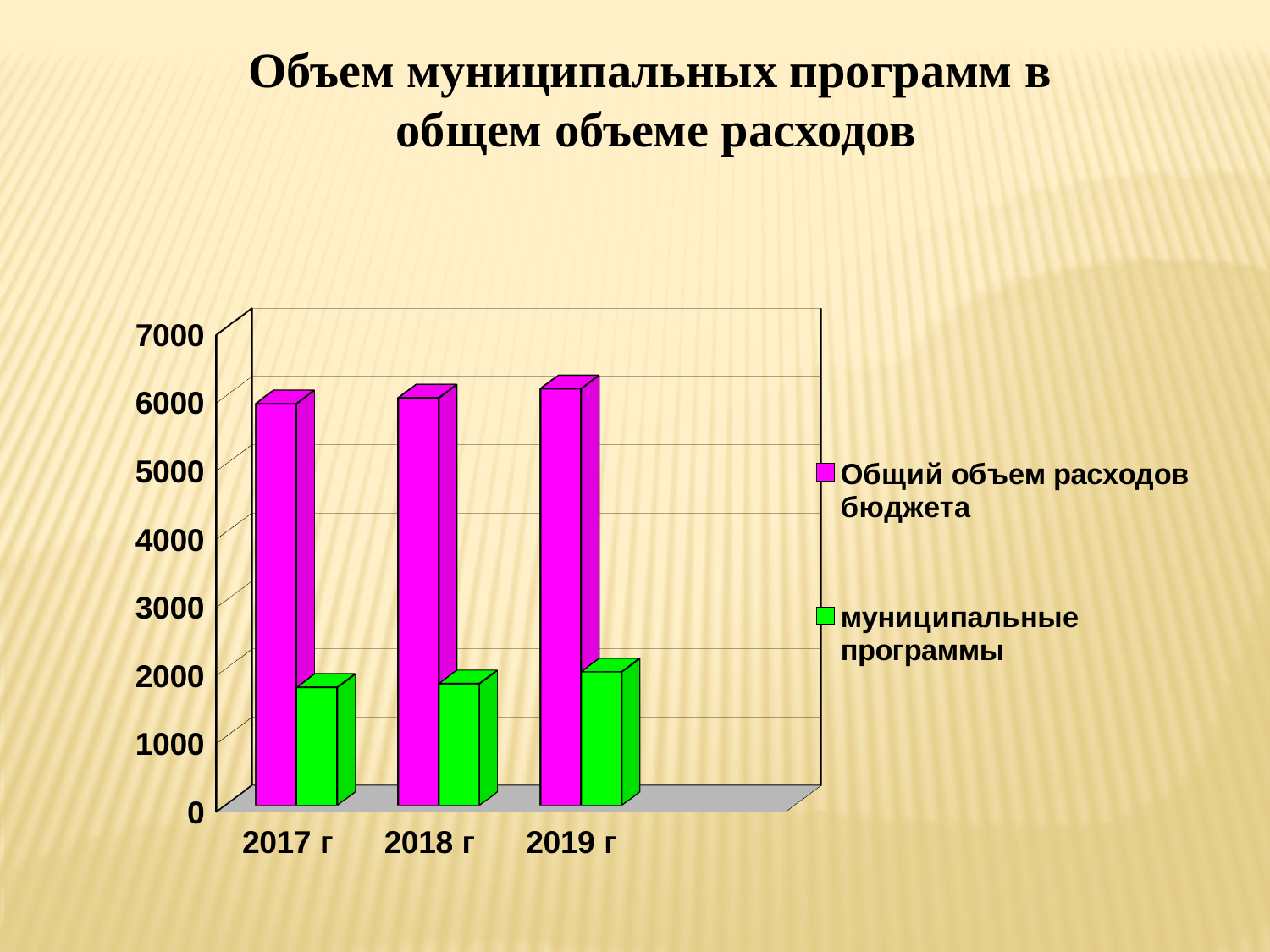
Do the values for Общий объем расходов бюджета rise or fall from 2017 г to 2019 г? rise How many years are shown on the x axis? 3 Is the value for муниципальные программы in 2017 г greater or less than 2000? less Is the value for Общий объем расходов бюджета in 2018 г greater or less than 7000? less What is the title of the chart? Объем муниципальных программ в общем объеме расходов Which series is shown in green? муниципальные программы In 2017 г, which is larger: Общий объем расходов бюджета or муниципальные программы? Общий объем расходов бюджета Do the values for муниципальные программы rise or fall from 2017 г to 2019 г? rise How many series does the legend list? 2 What kind of chart is shown on the slide? bar chart Is the value for муниципальные программы in 2019 г greater or less than 3000? less